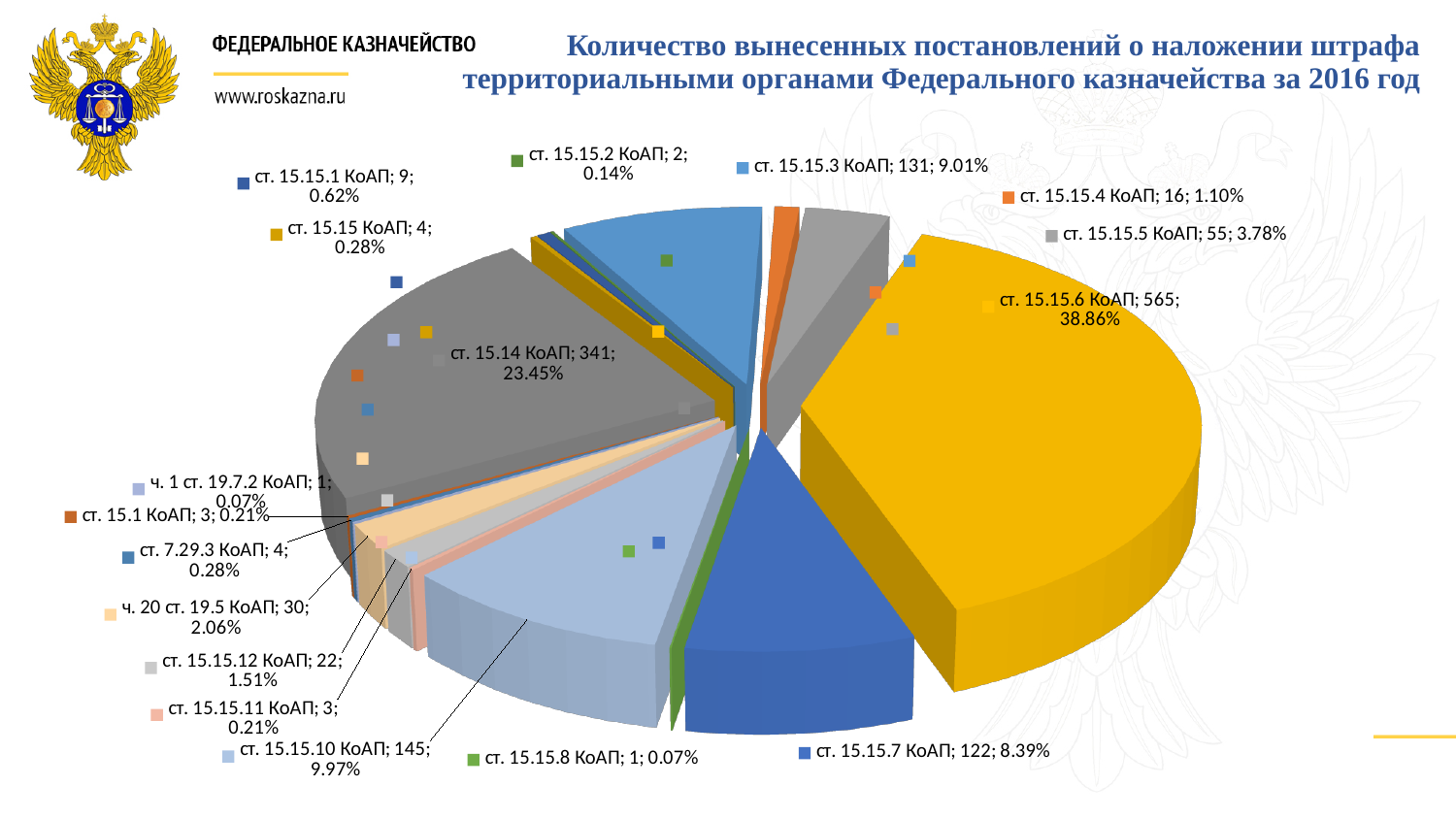
Which is larger, the value for ст. 15.15.3 КоАП or the value for ст. 15.15.7 КоАП? ст. 15.15.3 КоАП What percentage is shown for ст. 15.15.10 КоАП? 9.97% What is the value shown for ст. 15.14 КоАП? 341 Which category has the largest slice of the pie? ст. 15.15.6 КоАП What type of chart is shown on the slide? pie chart How many categories (slices) does the pie chart contain? 17 What year does the chart title say the data covers? 2016 How many postanovleniya (decisions) are shown for ст. 15.15.6 КоАП? 565 What percentage is shown for ст. 15.15.5 КоАП? 3.78% What is the value shown for ч. 20 ст. 19.5 КоАП? 30 What is the difference between the values for ст. 15.15.6 КоАП and ст. 15.14 КоАП? 224 What share of the pie does ст. 15.15.6 КоАП represent? 38.86%